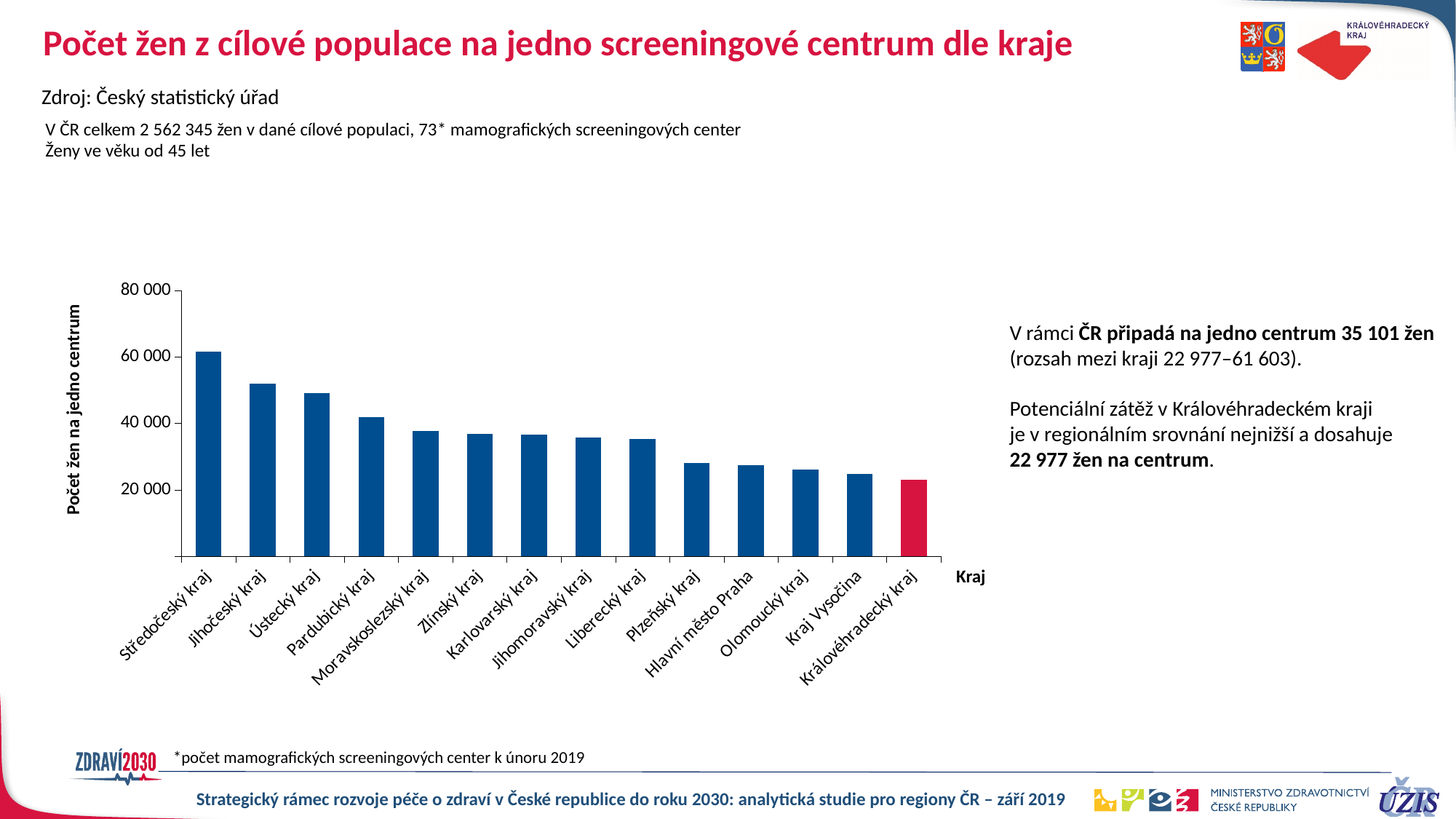
Is the value for Plzeňský kraj greater or less than 20 000? greater How many regions (kraje) are shown on the x axis of the chart? 14 Which region has the lowest number of women per screening centre? Královéhradecký kraj Is the value for Moravskoslezský kraj greater or less than 40 000? less Do the bar values rise or fall from left to right along the x axis? fall What kind of chart is shown on the slide? bar chart What is the difference between the highest (Středočeský kraj) and lowest (Královéhradecký kraj) values stated on the slide? 38 626 How many women per centre does Královéhradecký kraj have, according to the slide? 22 977 Is the value for Jihočeský kraj greater or less than 40 000? greater Which has a higher value, Pardubický kraj or Plzeňský kraj? Pardubický kraj What is the value for Středočeský kraj, the highest bar, according to the range stated on the slide? 61 603 Which region has the highest number of women per screening centre? Středočeský kraj